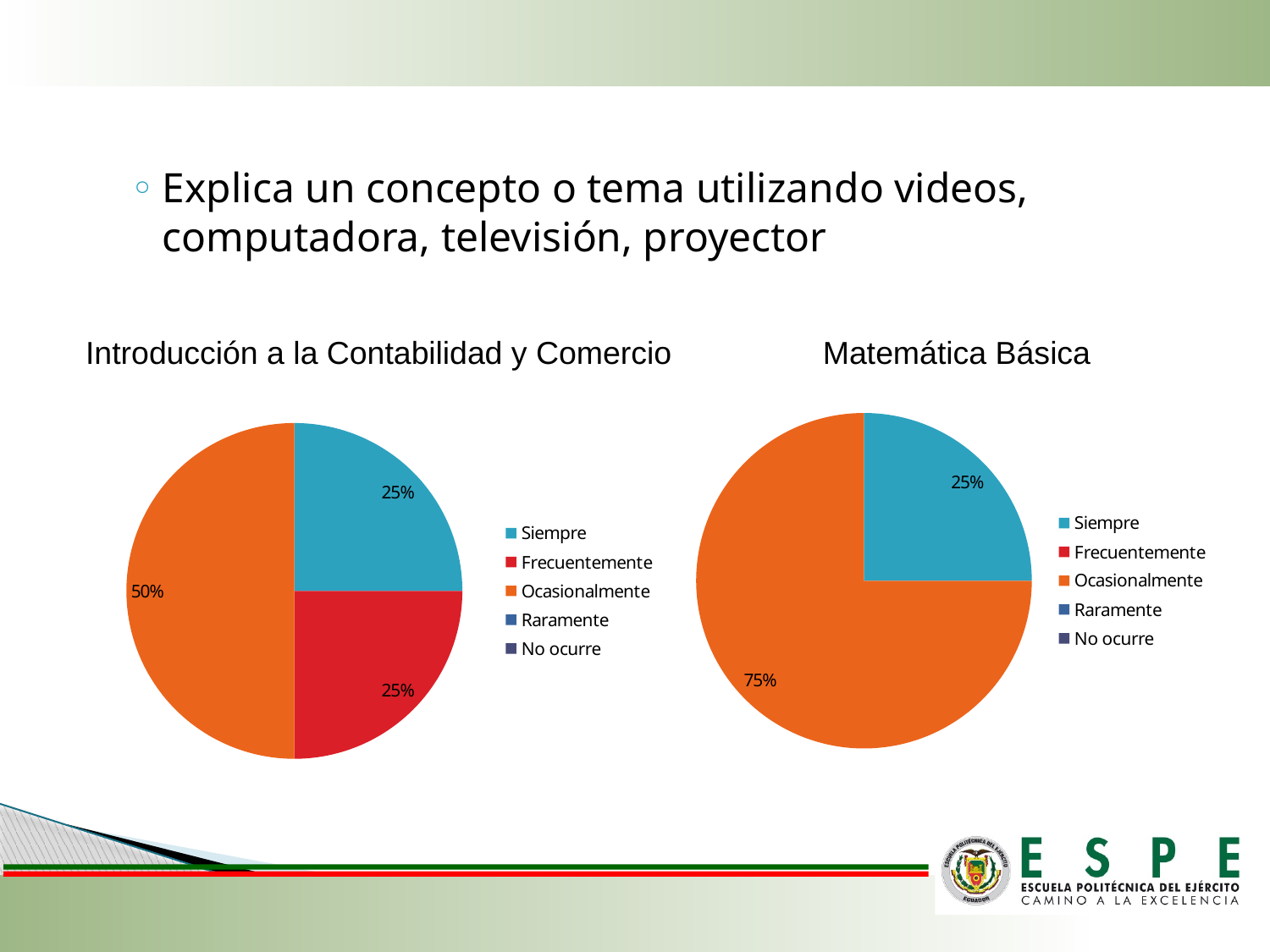
What type of chart is the 'Matemática Básica' chart? Pie chart How many entries does the legend of the 'Matemática Básica' chart list? 5 In the 'Introducción a la Contabilidad y Comercio' chart, which category has the largest slice? Ocasionalmente In the 'Introducción a la Contabilidad y Comercio' chart, what share does Siempre have? 25% In the 'Introducción a la Contabilidad y Comercio' chart, what share does Frecuentemente have? 25% In the 'Introducción a la Contabilidad y Comercio' chart, what share does Ocasionalmente have? 50% In the 'Matemática Básica' chart, what is the difference between the Ocasionalmente and Siempre shares? 50% In the 'Matemática Básica' chart, how many slices are shown in the pie? 2 In the 'Matemática Básica' chart, which category has the largest slice? Ocasionalmente In the 'Introducción a la Contabilidad y Comercio' chart, which is larger, Ocasionalmente or Frecuentemente? Ocasionalmente